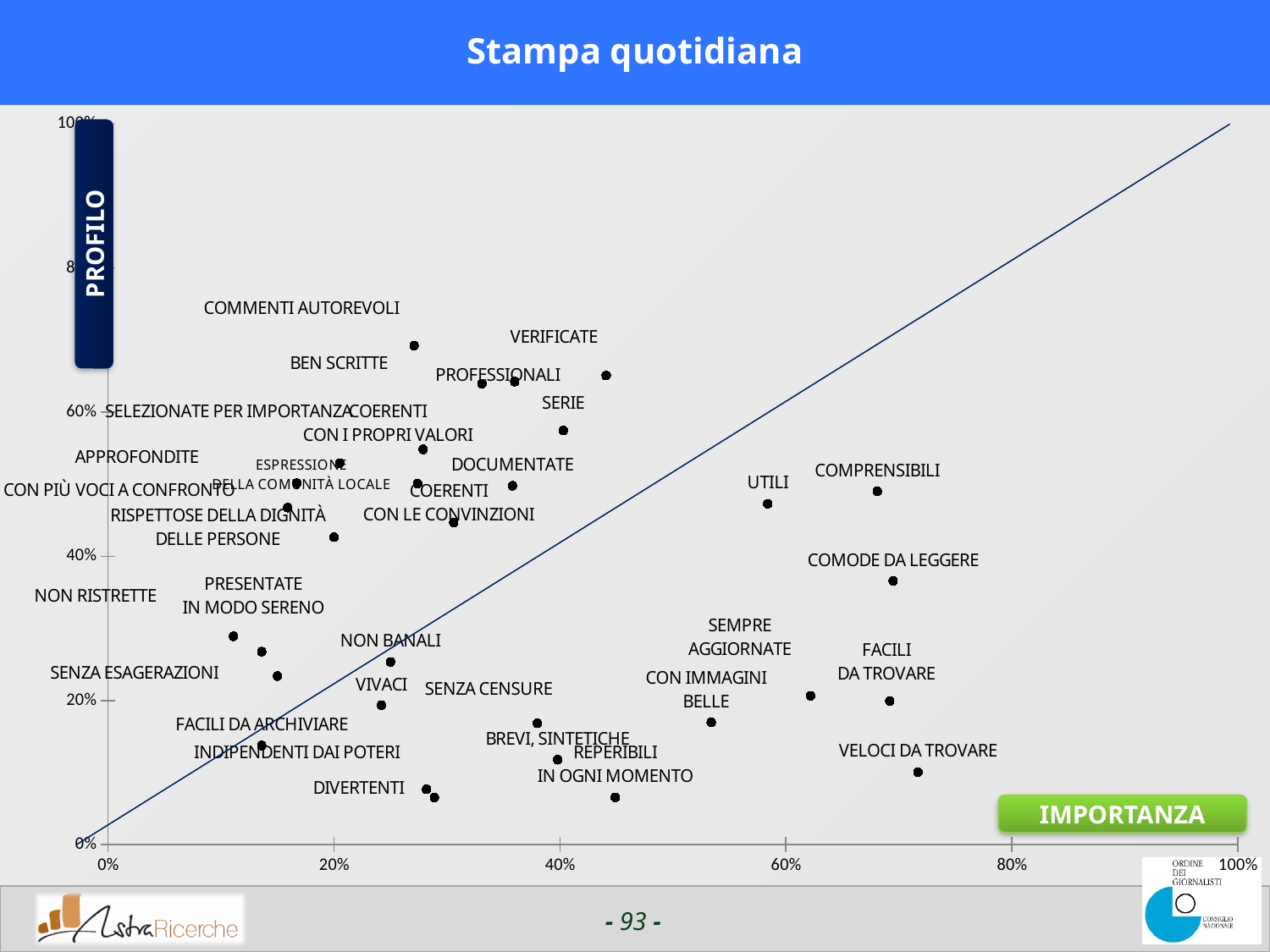
Is the IMPORTANZA value for COMPRENSIBILI greater or less than 60%? greater Is the PROFILO value for DIVERTENTI greater or less than 20%? less Is the PROFILO value for VELOCI DA TROVARE greater or less than 20%? less What is the title of the chart? Stampa quotidiana Which labelled point has the highest PROFILO value? COMMENTI AUTOREVOLI Which has the higher PROFILO value, COMMENTI AUTOREVOLI or DIVERTENTI? COMMENTI AUTOREVOLI What kind of chart is shown on the slide? Scatter chart What label is given to the vertical axis of the chart? PROFILO Which has the higher IMPORTANZA value, COMPRENSIBILI or NON RISTRETTE? COMPRENSIBILI